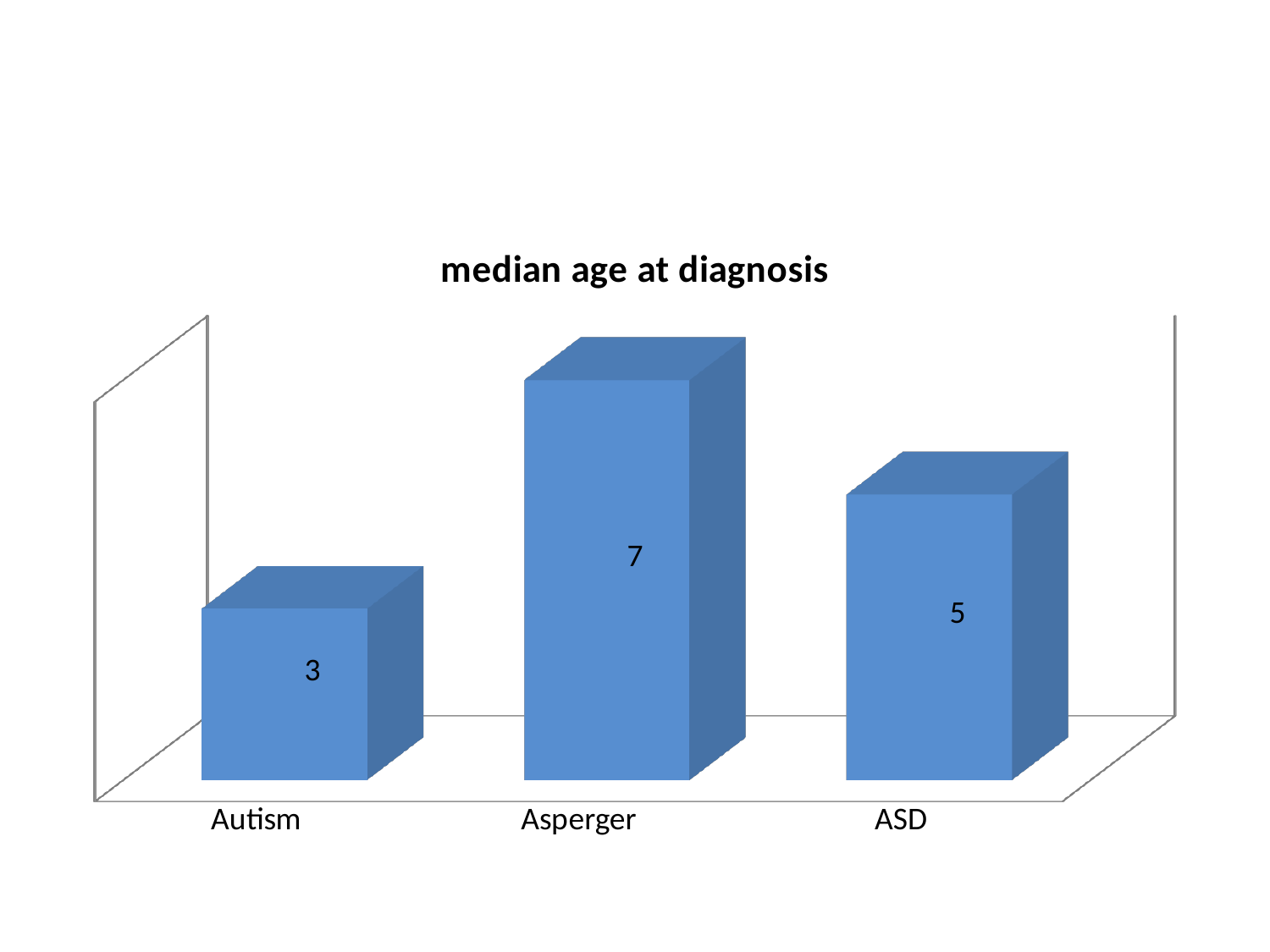
What is the median age at diagnosis for Asperger? 7 Which category has the highest median age at diagnosis? Asperger What kind of chart is shown on the slide? Bar chart What is the median age at diagnosis for ASD? 5 What is the title of the chart? median age at diagnosis What is the median age at diagnosis for Autism? 3 How many categories are shown in the chart? 3 Which has a higher median age at diagnosis, Asperger or ASD? Asperger Which has a higher median age at diagnosis, ASD or Autism? ASD Which category has the lowest median age at diagnosis? Autism What is the difference between the median age at diagnosis for Asperger and for Autism? 4 What is the difference between the median age at diagnosis for ASD and for Autism? 2